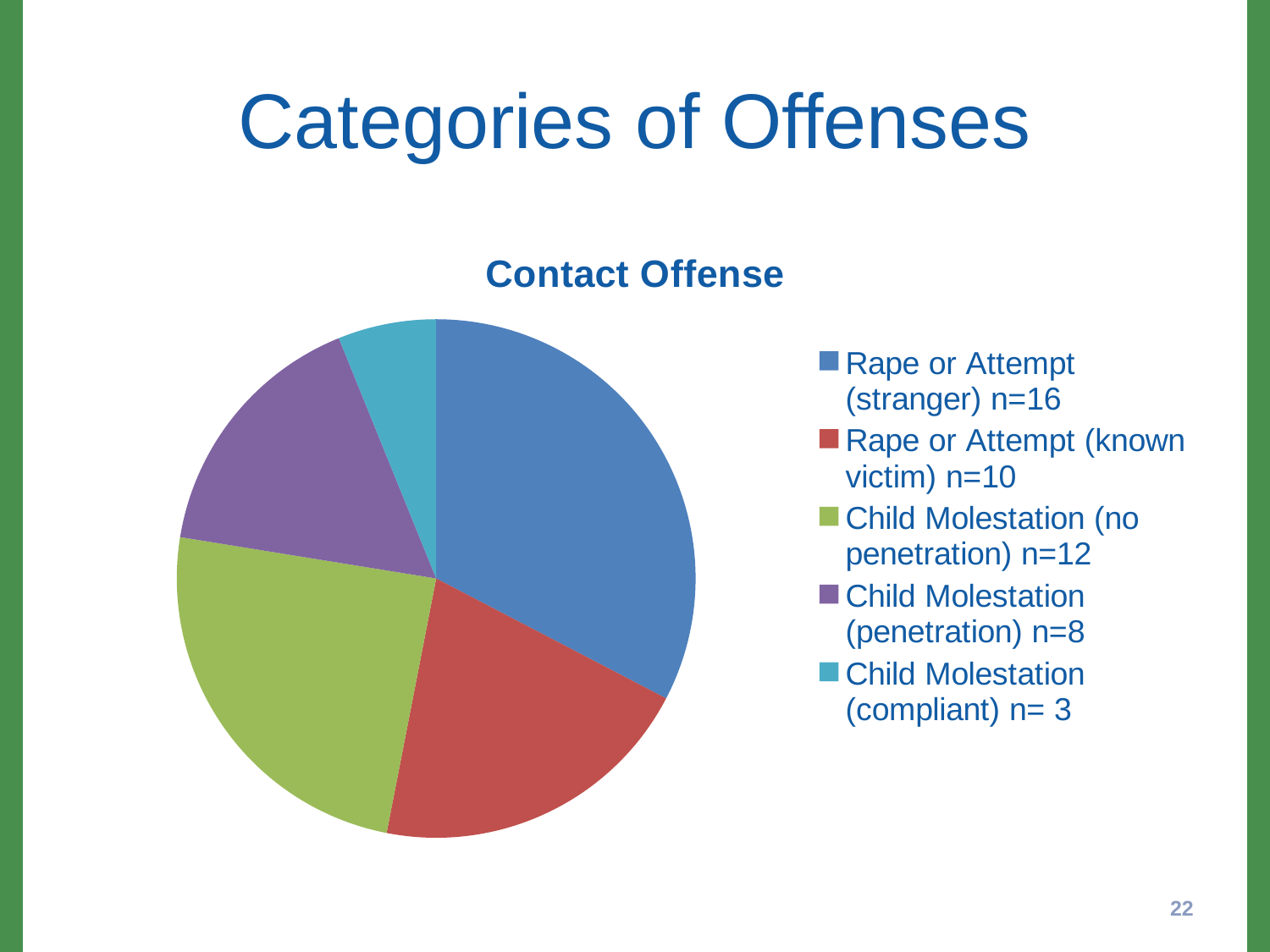
What is the difference between the n values for Rape or Attempt (stranger) and Rape or Attempt (known victim)? 6 How many categories does the pie chart have? 5 What is the title of the chart? Contact Offense What is the n value for Child Molestation (no penetration)? n=12 Which category has the smallest slice of the pie? Child Molestation (compliant) What is the n value for Rape or Attempt (stranger)? n=16 What kind of chart is shown on the slide? Pie chart What colour is the slice for Child Molestation (penetration)? Purple Which is larger: Child Molestation (no penetration) or Child Molestation (penetration)? Child Molestation (no penetration) What is the total n across all five categories in the pie chart? 49 What is the n value for Child Molestation (compliant)? n= 3 Which category has the largest slice of the pie? Rape or Attempt (stranger)